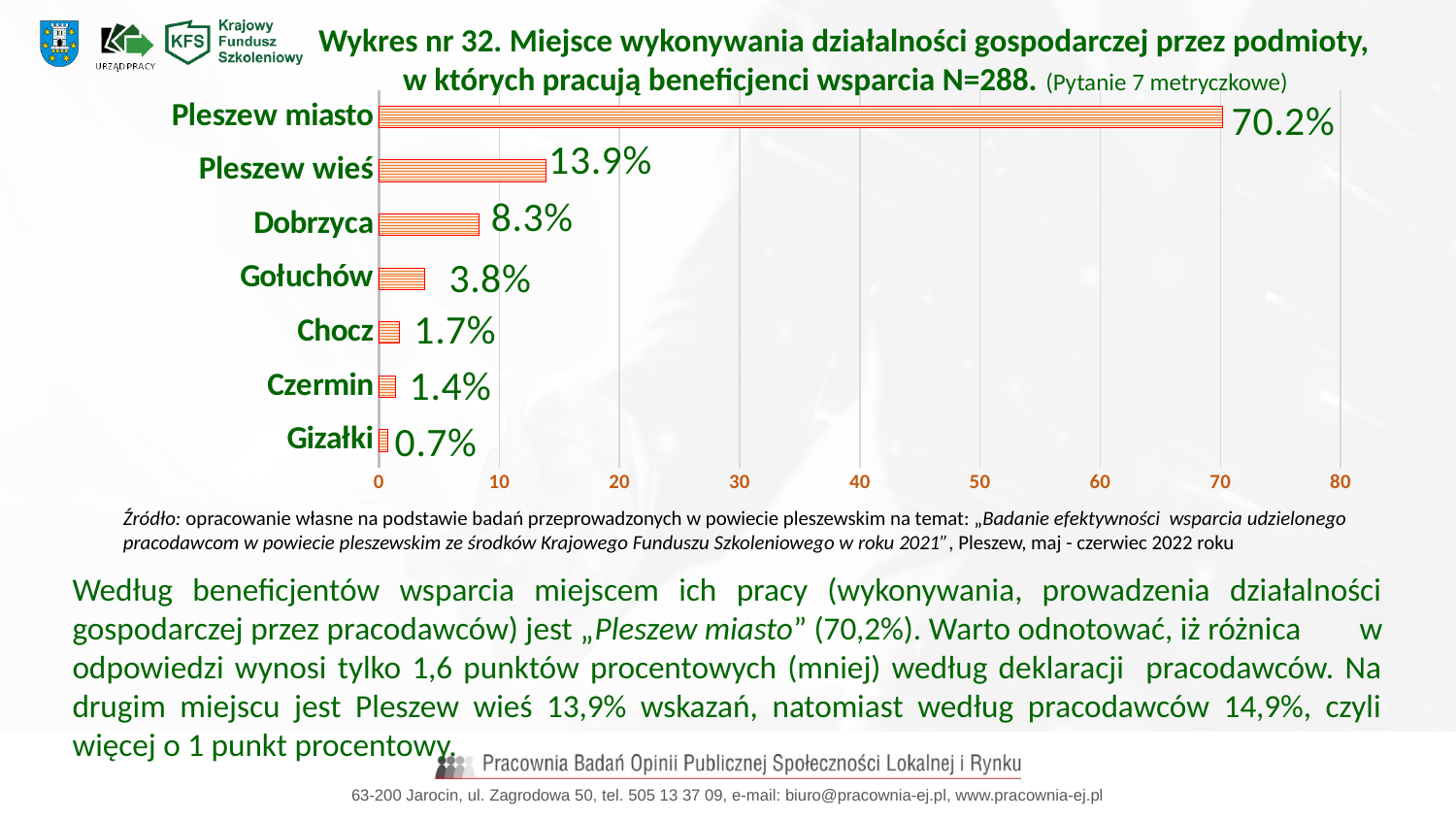
What is the value for Pleszew miasto? 70.2% What is the value for Dobrzyca? 8.3% What is the highest value shown on the horizontal axis? 80 Which category has the highest value? Pleszew miasto Is the value for Pleszew wieś greater or less than 10? greater What is the difference between the values for Pleszew miasto and Pleszew wieś? 56.3 percentage points What is the difference between the values for Chocz and Czermin? 0.3 percentage points What is the value for Gołuchów? 3.8% What kind of chart is shown on the slide? Bar chart How many categories are shown in the chart? 7 Which category has the lowest value? Gizałki Which is larger, the value for Dobrzyca or the value for Gołuchów? Dobrzyca